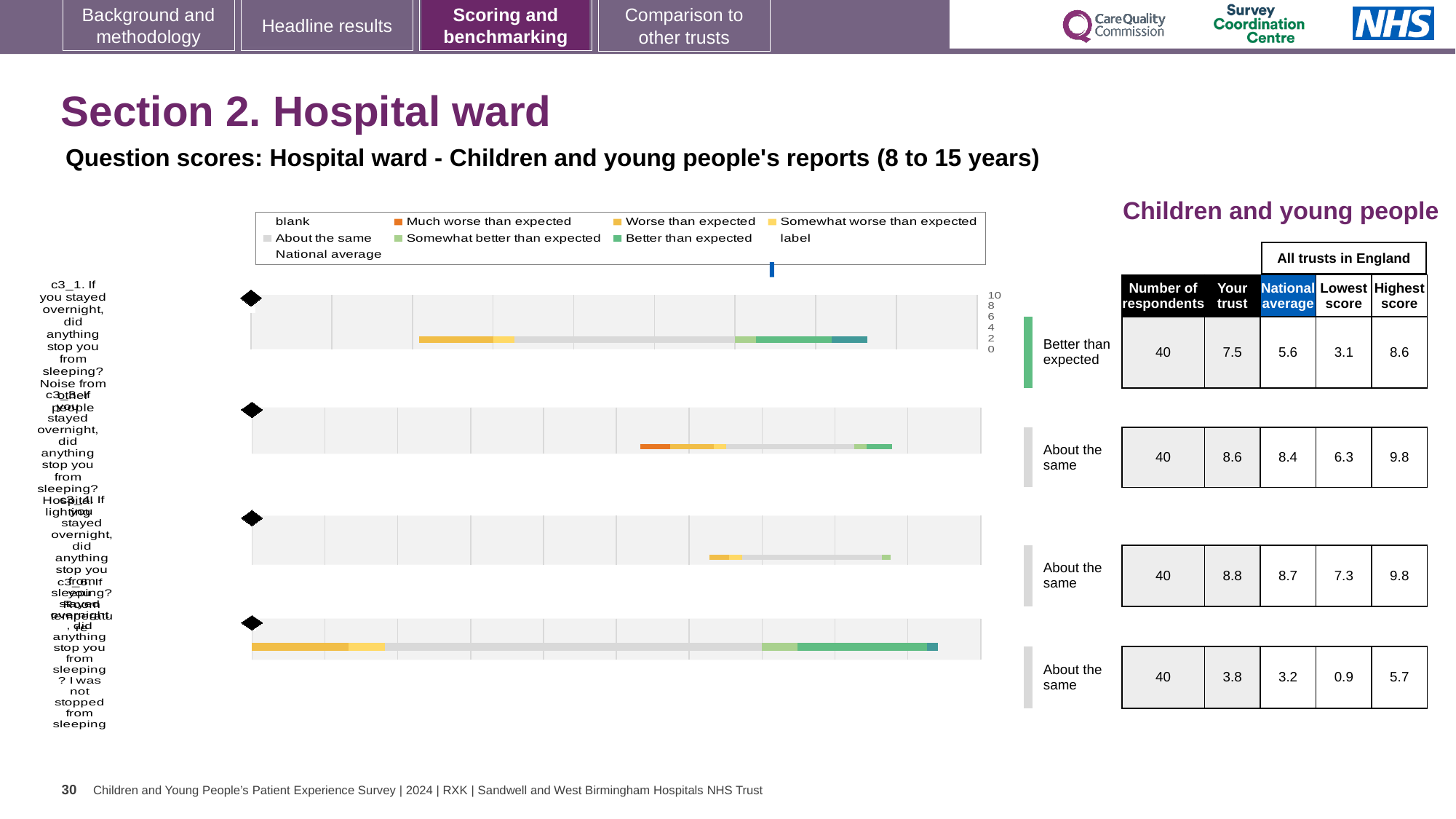
Which legend entry is shown in orange? Much worse than expected What is the lowest score listed in the table for the bottom chart (c3_6)? 0.9 For the bottom chart (c3_6), which is larger: the 'Your trust' score or the national average? Your trust How many respondents are listed for the second chart (c3_3)? 40 For the top chart (c3_1), what is the national average score shown in the table? 5.6 For the top chart (c3_1), what is the difference between the highest score and the lowest score in the table? 5.5 What is the benchmark category shown next to the top chart (c3_1)? Better than expected For the top chart (c3_1), what is the 'Your trust' score shown in the table? 7.5 How many entries does the chart legend list? 9 How many separate question charts are shown on the slide? 4 What kind of chart is used to show the benchmarking results for each question on this slide? bar chart Which of the four charts has the highest 'Your trust' score in the table? the third chart (8.8)